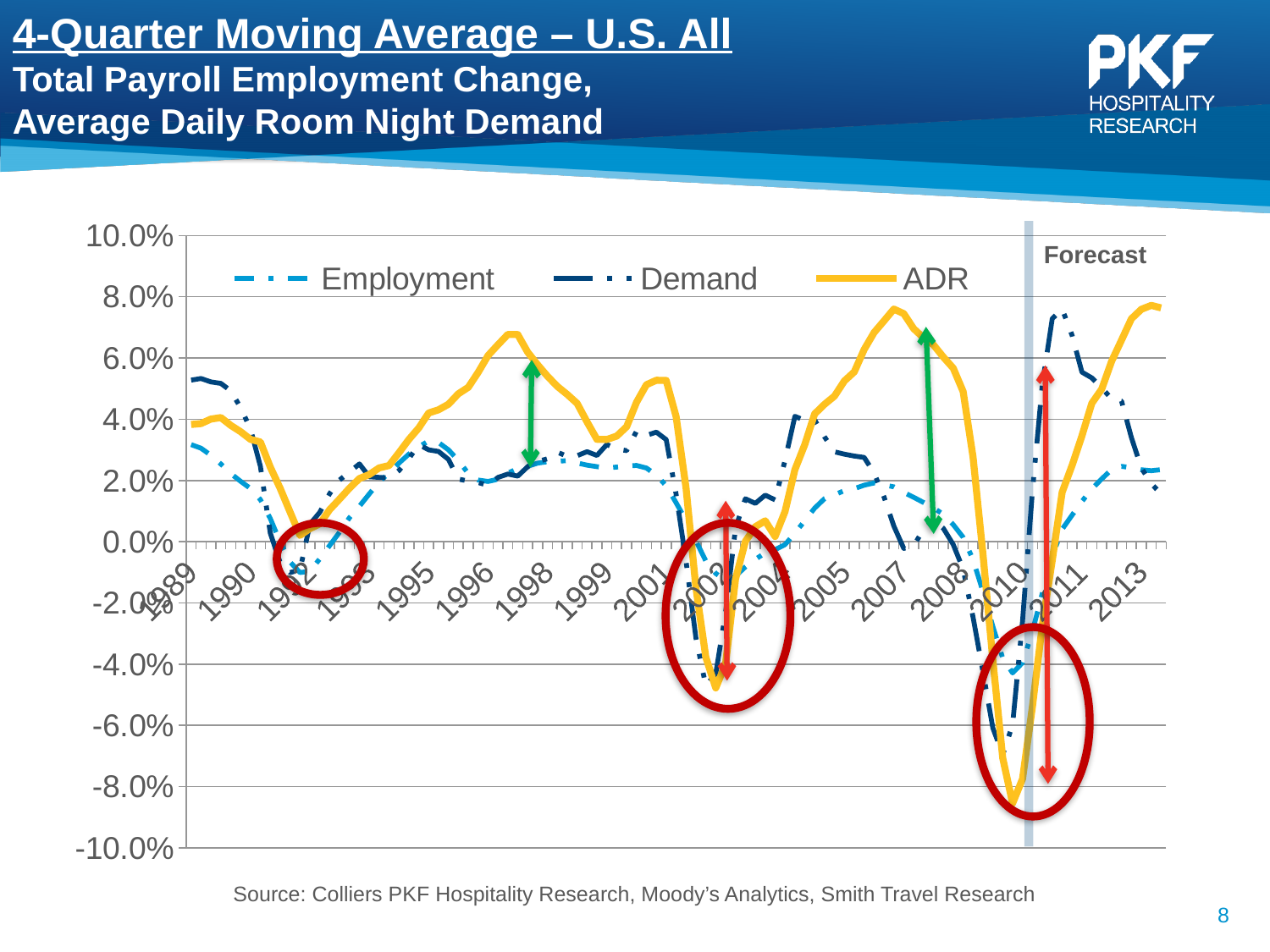
Around 2010, which series drops lower: ADR or Employment? ADR Is the peak of the ADR series around 1998 greater or less than 4.0%? greater What are the three series named in the legend? Employment, Demand, ADR How many series does the legend list? 3 Is the peak of the Employment series around 1995 greater or less than 2.0%? greater Which series reaches the lowest value anywhere on the chart? ADR Is the lowest value of the ADR series around 2010 greater or less than -6.0%? less What label marks the shaded region at the right side of the chart? Forecast What kind of chart is shown on the slide? line chart Around 2007, which series is higher: ADR or Employment? ADR